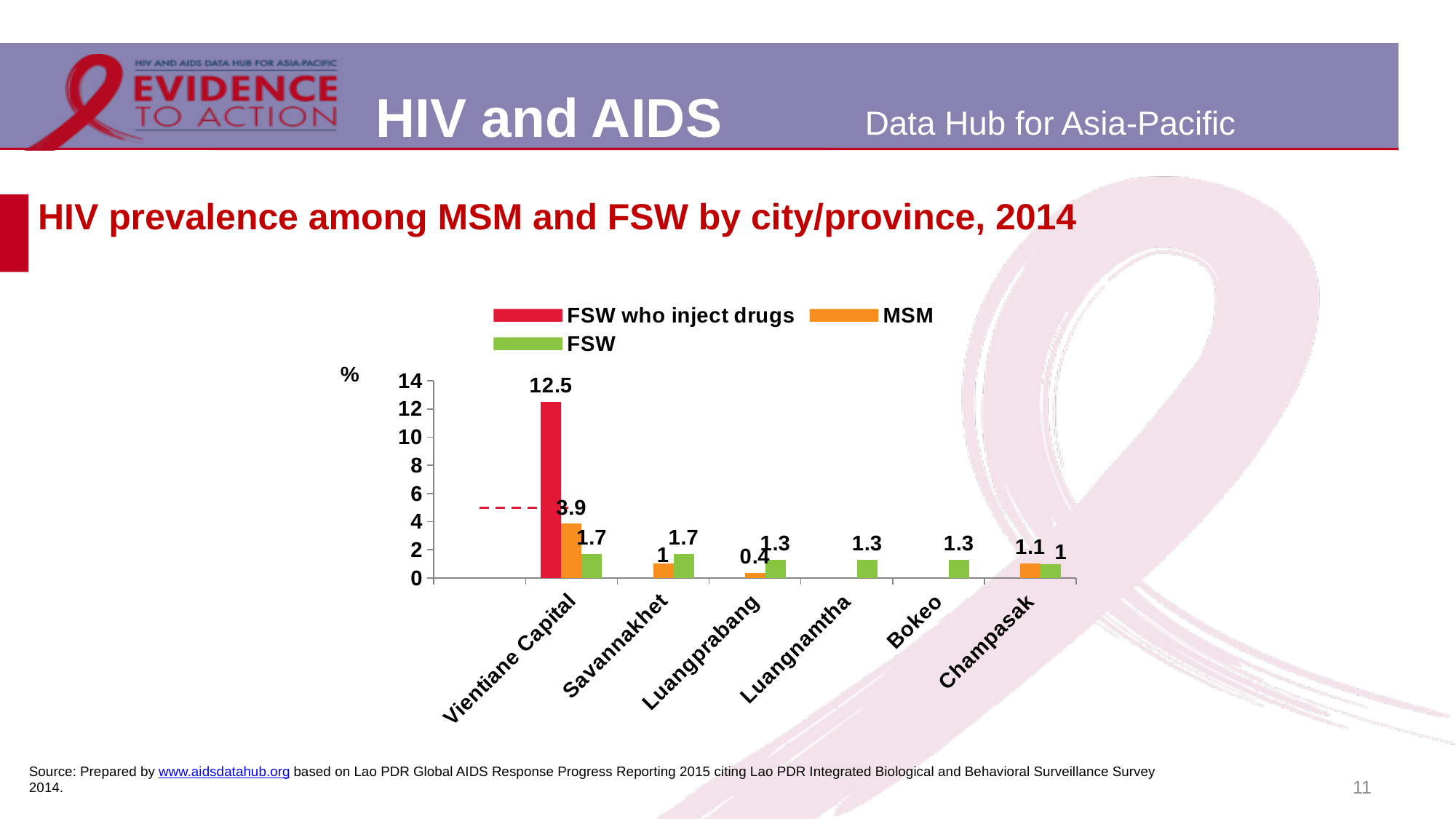
Which city/province has the highest HIV prevalence among MSM? Vientiane Capital How many series does the legend list? 3 What is the HIV prevalence among MSM in Champasak? 1.1 How many cities/provinces are shown on the x axis? 6 In Luangprabang, which is higher: HIV prevalence among MSM or among FSW? FSW What is the HIV prevalence among MSM in Vientiane Capital? 3.9 What is the HIV prevalence among FSW in Savannakhet? 1.7 What is the difference between HIV prevalence among FSW who inject drugs and among MSM in Vientiane Capital? 8.6 What is the HIV prevalence among MSM in Luangprabang? 0.4 What type of chart is shown on the slide? Bar chart Which city/province has the lowest HIV prevalence among MSM? Luangprabang What is the HIV prevalence among FSW who inject drugs in Vientiane Capital? 12.5